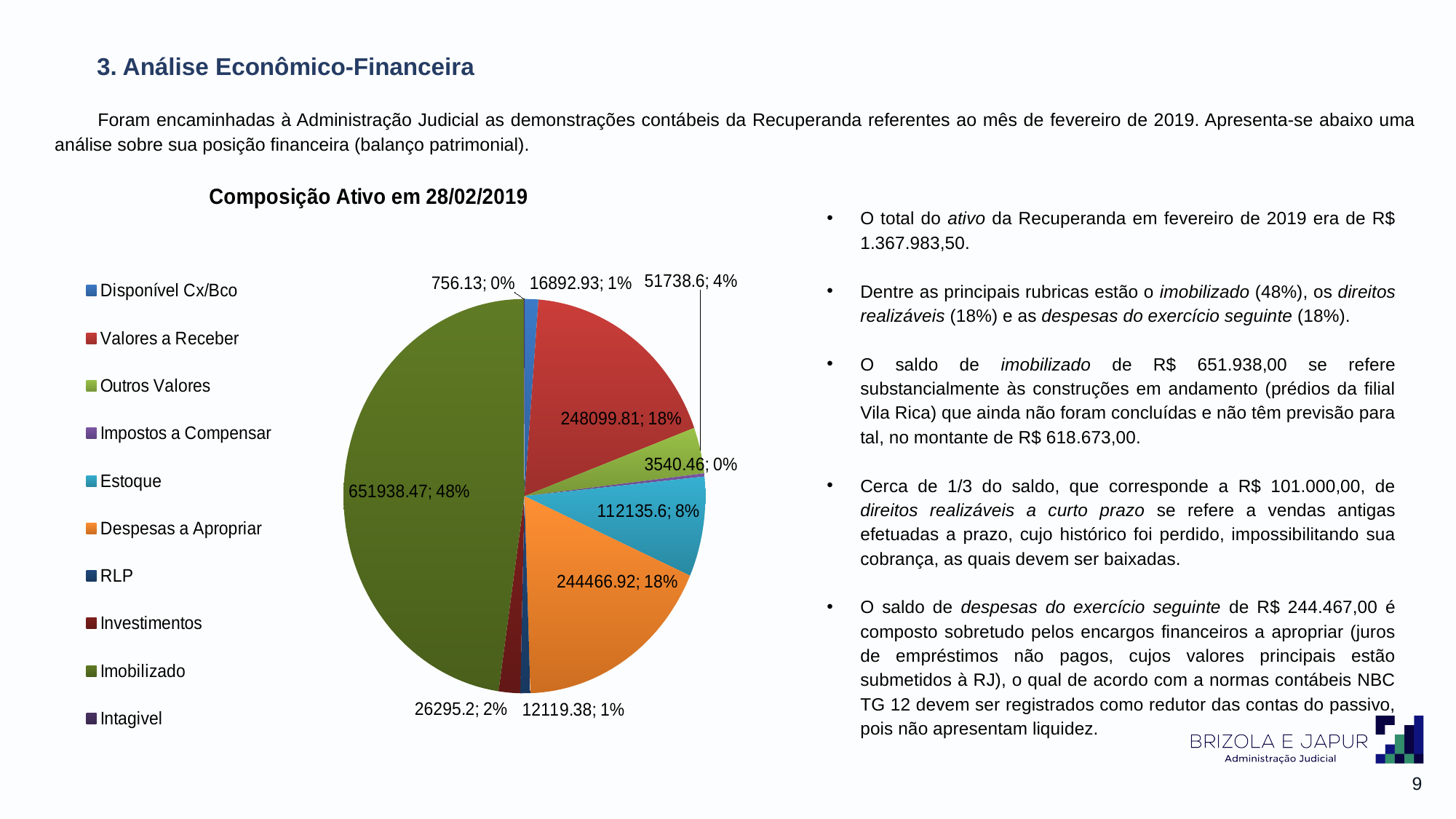
What is the value shown for Imobilizado? 651938.47 Which is larger, the value for Estoque or the value for Outros Valores? Estoque What kind of chart is shown on the slide? pie chart What is the smallest value shown among the data labels on the pie? 756.13 What is the value shown for Estoque? 112135.6 Which category has the largest slice of the pie? Imobilizado What is the value shown for Valores a Receber? 248099.81 What share of the pie does Despesas a Apropriar represent? 18% How many categories does the chart's legend list? 10 What share of the pie does Imobilizado represent? 48% What is the difference between the values for Valores a Receber and Despesas a Apropriar? 3632.89 What is the title of the chart? Composição Ativo em 28/02/2019